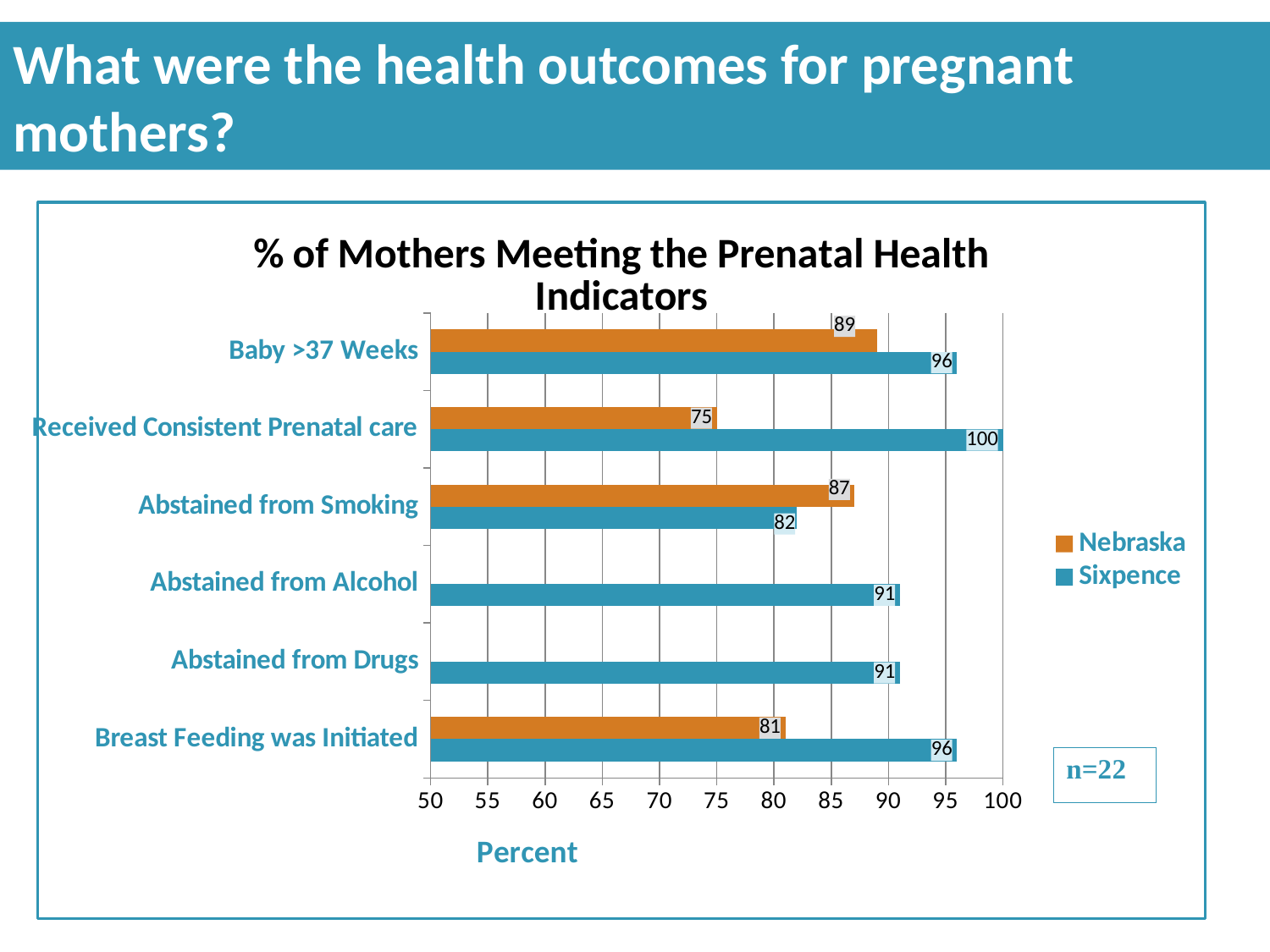
How many series does the legend list? 2 What is the Nebraska value for Breast Feeding was Initiated? 81 How many categories are shown on the y axis? 6 For Abstained from Smoking, which series has the larger value, Nebraska or Sixpence? Nebraska What is the title of the chart? % of Mothers Meeting the Prenatal Health Indicators Which category has the lowest Nebraska value? Received Consistent Prenatal care What is the Nebraska value for Baby >37 Weeks? 89 What is the Sixpence value for Abstained from Smoking? 82 Which category has the highest Sixpence value? Received Consistent Prenatal care What is the Sixpence value for Received Consistent Prenatal care? 100 What is the difference between the Sixpence and Nebraska values for Received Consistent Prenatal care? 25 What kind of chart is shown? bar chart